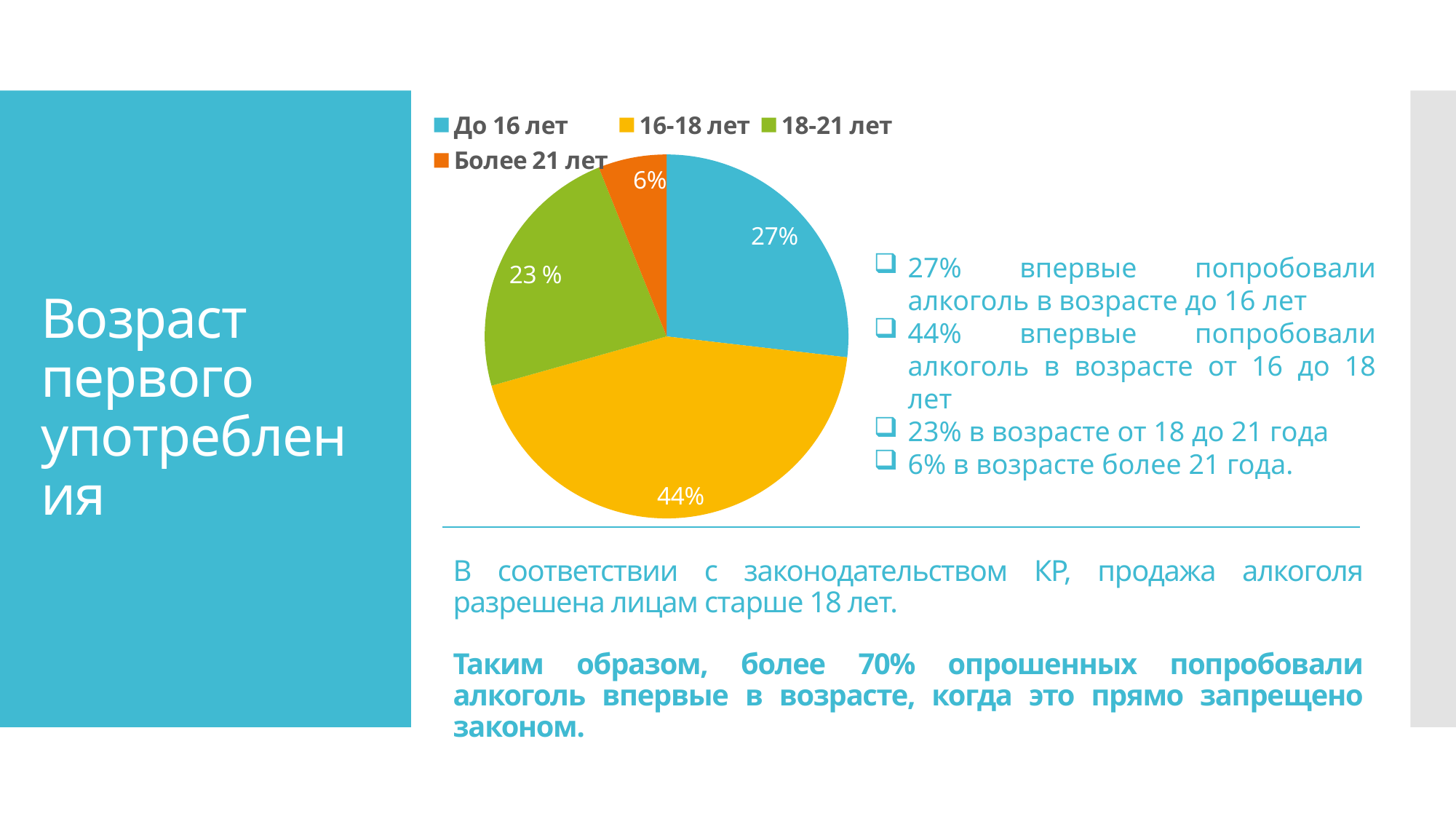
What share of the pie does the 'Более 21 лет' slice represent? 6% Which category has the smallest slice of the pie? Более 21 лет What share of the pie does the '16-18 лет' slice represent? 44% How many categories does the pie chart have? 4 What colour is the '16-18 лет' slice? yellow How many entries does the legend list? 4 Which category has the largest slice of the pie? 16-18 лет What type of chart is shown on the slide? pie chart What share of the pie does the 'До 16 лет' slice represent? 27% Which slice is larger: 'До 16 лет' or '18-21 лет'? До 16 лет What is the difference in percentage points between the '16-18 лет' slice and the 'До 16 лет' slice? 17